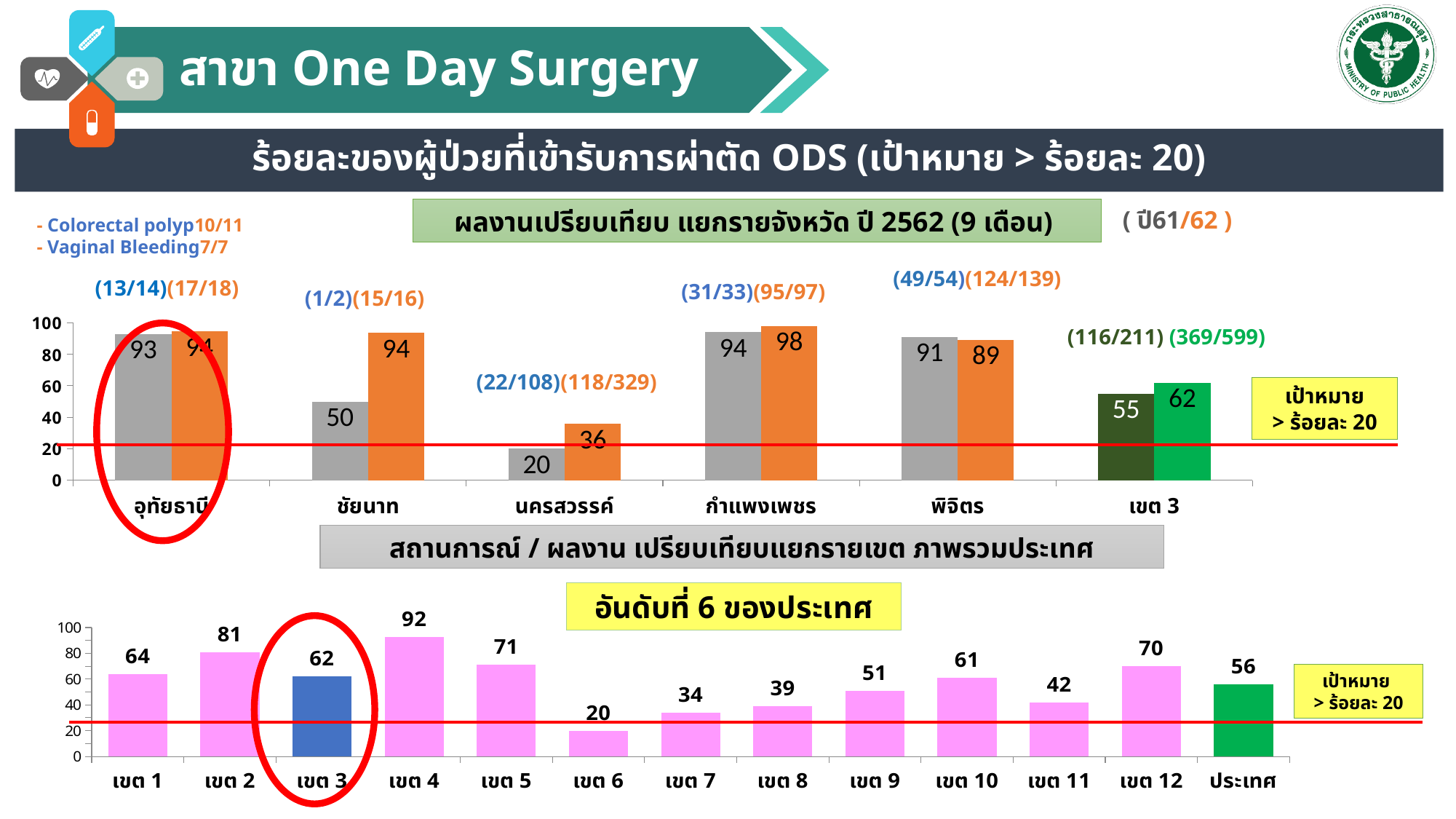
How many categories are shown in the bottom chart? 13 In the top chart, what is the difference between the orange bar and the grey bar for ชัยนาท? 44 In the bottom chart, what is the value for ประเทศ? 56 In the bottom chart, what is the value for เขต 4? 92 In the bottom chart, what is the difference between the values for เขต 2 and เขต 3? 19 In the bottom chart, which category has the highest value? เขต 4 In the bottom chart, which is larger, the value for เขต 12 or the value for เขต 10? เขต 12 In the top chart, what is the value of the grey bar for ชัยนาท? 50 In the top chart, what is the value of the orange bar for นครสวรรค์? 36 In the bottom chart, which category has the lowest value? เขต 6 What kind of chart is the bottom chart? bar chart In the top chart, which is larger for พิจิตร, the grey bar or the orange bar? grey bar